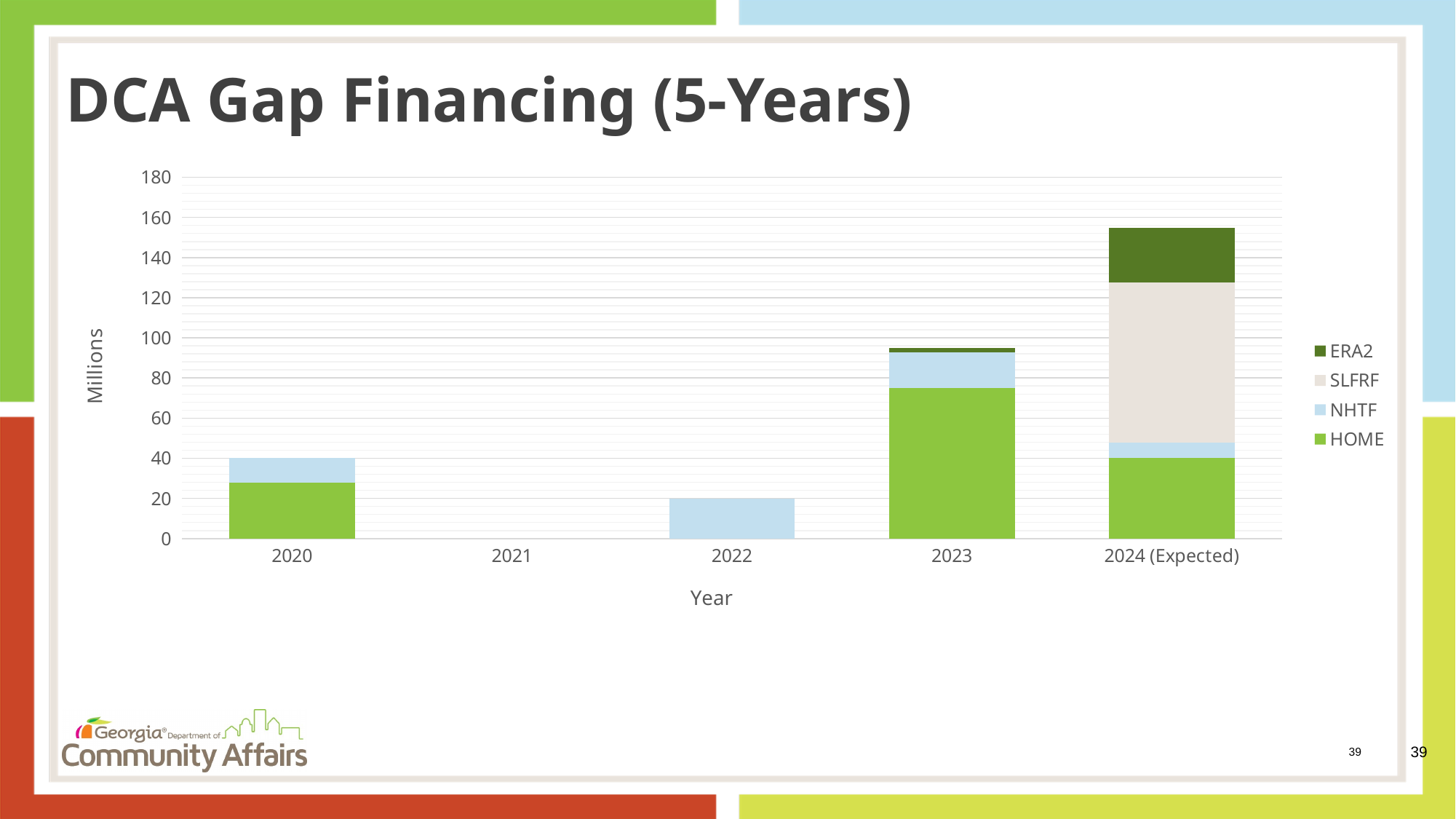
Is the total for 2024 (Expected) greater or less than 140? greater Which series appears only in the 2024 (Expected) bar? SLFRF Is the HOME value for 2023 greater or less than 60? greater What kind of chart is shown on the slide? bar chart How many series does the legend list? 4 What is the label on the y axis? Millions Do the total values rise or fall from 2022 to 2024 (Expected)? rise Which year has the highest total gap financing? 2024 (Expected) Is the total for 2023 greater or less than 80? greater Which year shows no gap financing at all? 2021 Which year has the larger total, 2020 or 2023? 2023 How many years are shown on the x axis? 5